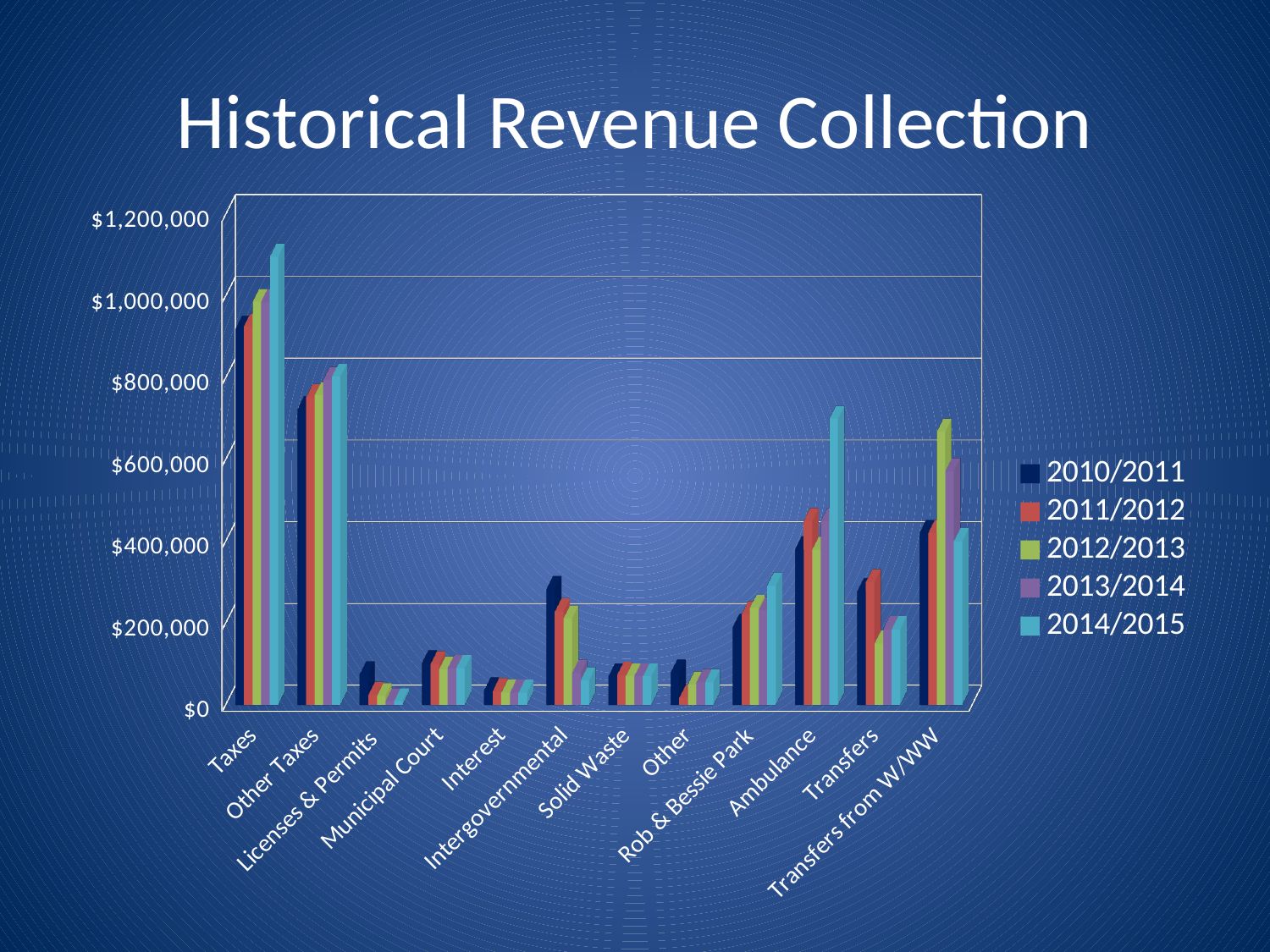
Which revenue category has the tallest bars overall? Taxes How many fiscal years (series) does the legend list? 5 In 2014/2015, which is larger: Ambulance or Transfers? Ambulance What kind of chart is shown on the slide? Bar chart Is the 2014/2015 value for Ambulance greater or less than $600,000? greater In 2014/2015, which is larger: Taxes or Other Taxes? Taxes Is the 2014/2015 value for Solid Waste greater or less than $200,000? less Do the Ambulance values generally rise or fall from 2010/2011 to 2014/2015? Rise Is the 2010/2011 value for Intergovernmental greater or less than $200,000? greater What is the title of the chart? Historical Revenue Collection How many revenue categories are shown along the x axis? 12